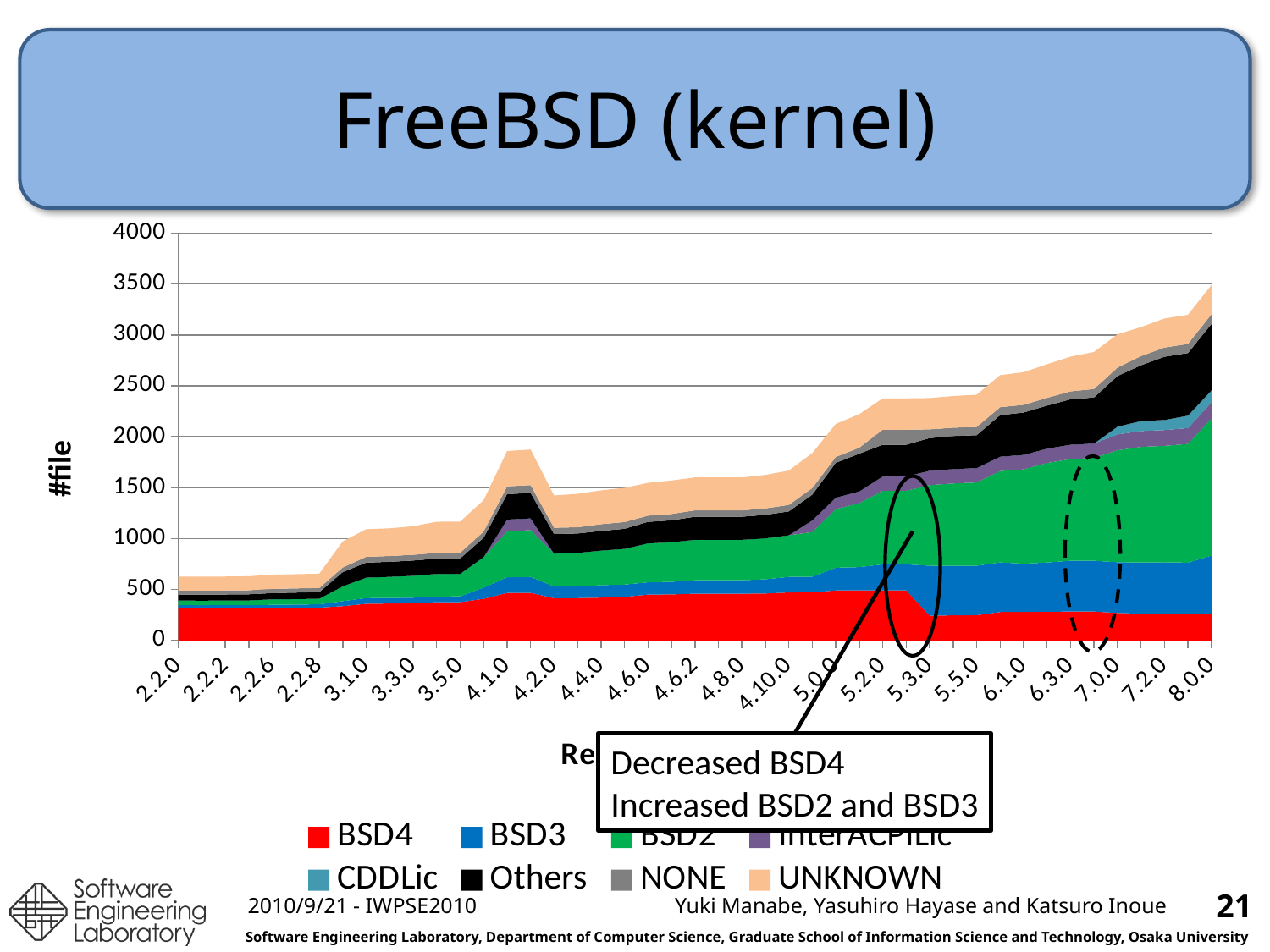
How many series does the legend list? 8 What kind of chart is shown on the slide? stacked area chart Does the total number of files generally rise or fall from release 2.2.0 to 8.0.0? rise Is the total number of files at release 2.2.0 greater or less than 1000? less What is the label on the y axis? #file Which release has a larger total number of files, 4.1.0 or 4.2.0? 4.1.0 Which release has the highest total number of files? 8.0.0 Which series is plotted at the bottom of the stack? BSD4 Is the total number of files at release 8.0.0 greater or less than 3000? greater Is the number of BSD4 files at release 8.0.0 greater or less than 500? less